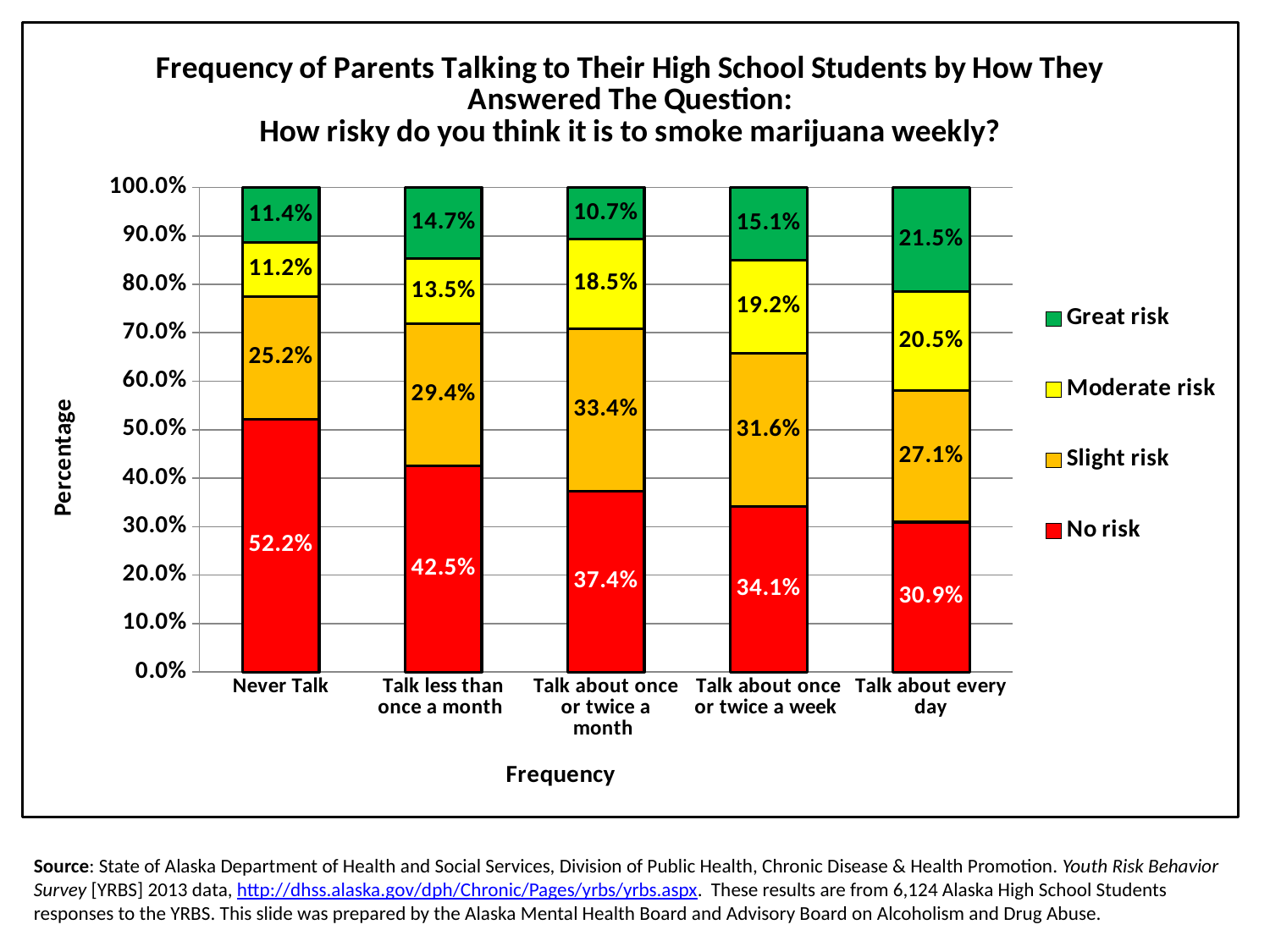
What colour represents the No risk series in the legend? Red How many frequency categories are shown on the x axis? 5 What kind of chart is shown on the slide? Stacked bar chart What is the Great risk value for the Talk about every day category? 21.5% Which category has the highest No risk percentage? Never Talk What percentage of students whose parents Never Talk answered No risk? 52.2% Does the No risk percentage rise or fall as you move from Never Talk to Talk about every day? Fall What is the Moderate risk value for the Talk about once or twice a week category? 19.2% Which category has the lowest Great risk percentage? Talk about once or twice a month What is the difference between the No risk value for Never Talk and the No risk value for Talk about every day? 21.3 percentage points Which has the larger Slight risk value: Talk about once or twice a month or Talk about once or twice a week? Talk about once or twice a month How many series does the legend list? 4